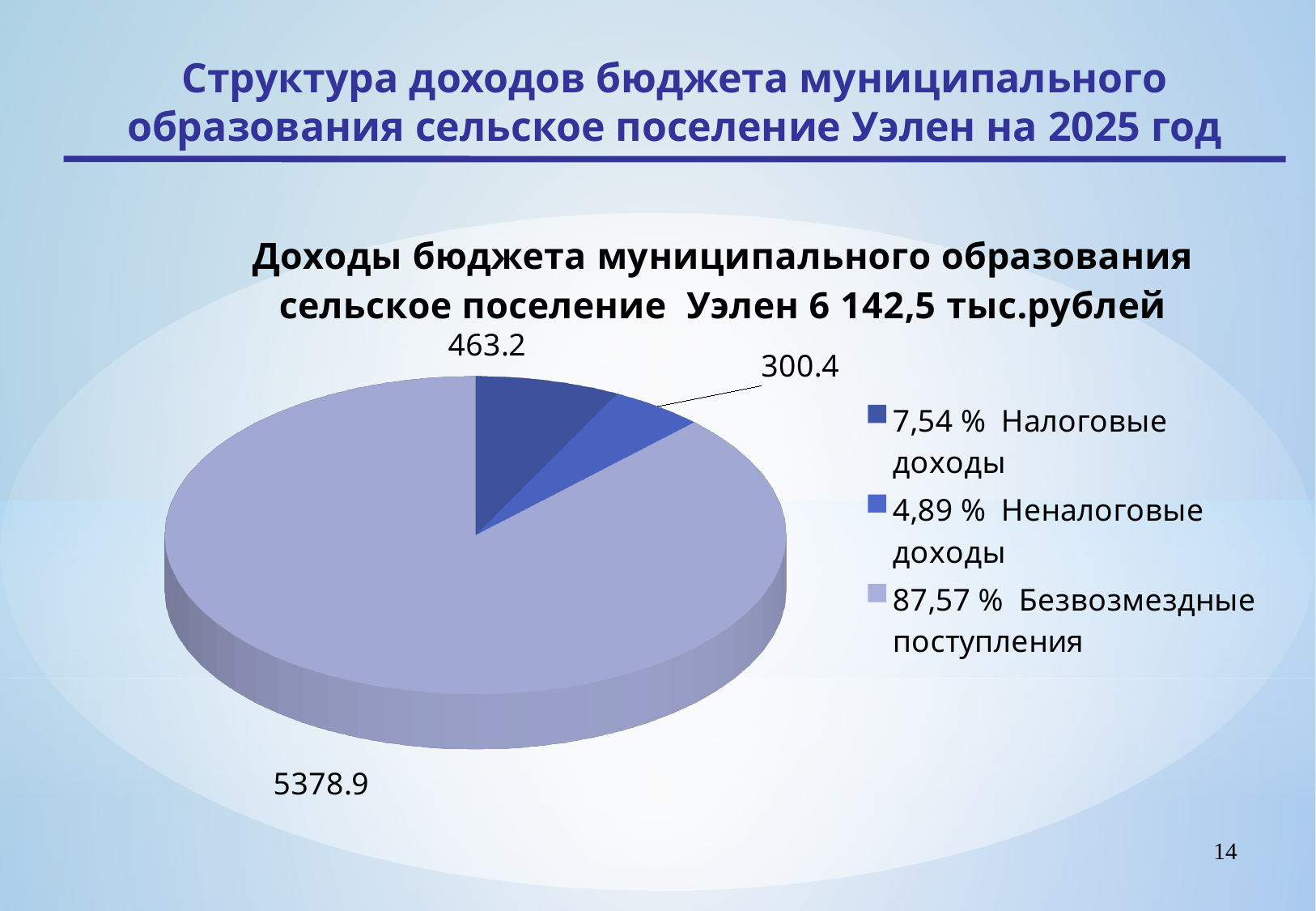
What share of the pie does Безвозмездные поступления represent according to the legend? 87,57 % Which is larger, Налоговые доходы or Неналоговые доходы? Налоговые доходы What is the difference between the Налоговые доходы value and the Неналоговые доходы value? 162.8 What is the value of the Налоговые доходы slice? 463.2 Which category has the largest slice of the pie? Безвозмездные поступления What is the difference between the Безвозмездные поступления value and the Налоговые доходы value? 4915.7 What total amount in thousand rubles is stated in the chart title? 6 142,5 тыс.рублей What is the value of the Неналоговые доходы slice? 300.4 What type of chart is shown on the slide? pie chart What is the value of the Безвозмездные поступления slice? 5378.9 How many slices does the pie chart have? 3 Which category has the smallest slice of the pie? Неналоговые доходы